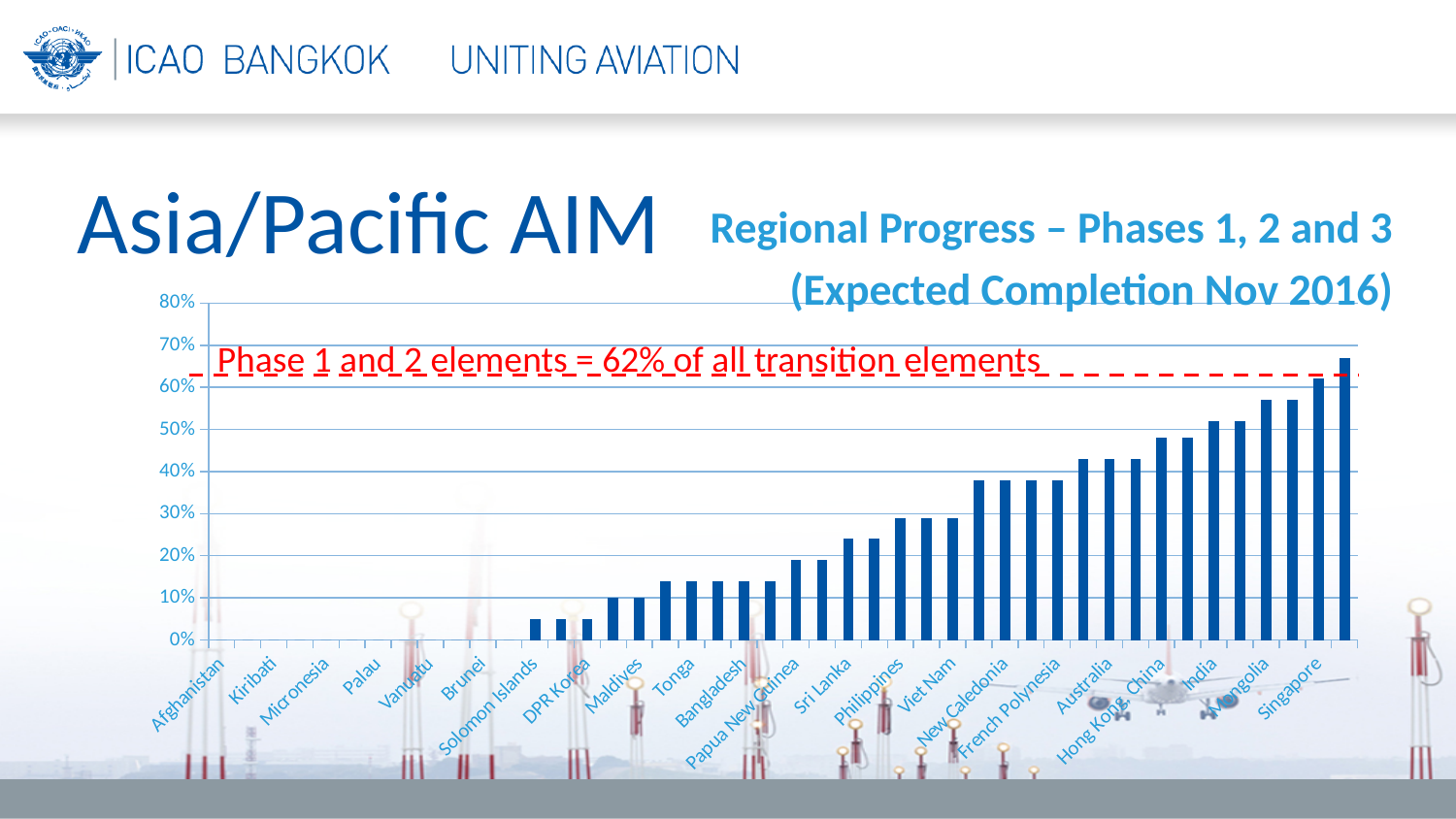
What is the highest percentage tick shown on the vertical axis? 80% Is the value for New Caledonia greater or less than 30%? greater According to the annotation on the chart, Phase 1 and 2 elements make up what percentage of all transition elements? 62% Do the bar values generally rise or fall from left to right across the chart? rise Is the value for Australia greater or less than 40%? greater Is the value for Viet Nam greater or less than 20%? greater What kind of chart is shown on the slide? bar chart Which has the larger value, Australia or Tonga? Australia What is the value shown for Afghanistan? 0% What is the value shown for Kiribati? 0%